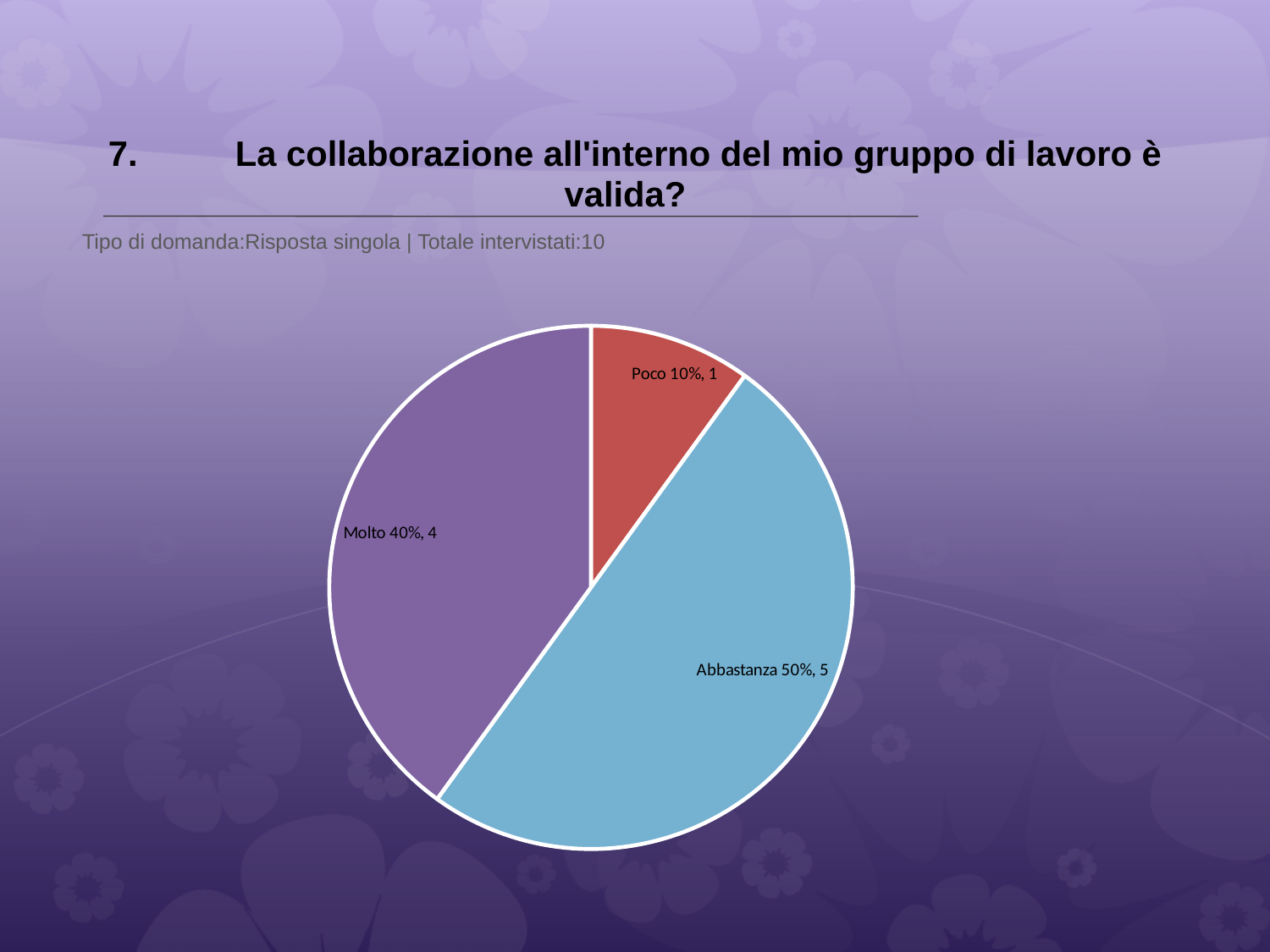
How many respondents answered 'Molto'? 4 Which response category has the largest slice? Abbastanza Which response category has the smallest slice? Poco How many slices does the pie chart have? 3 What kind of chart is shown on the slide? pie chart What percentage share does the 'Abbastanza' slice have? 50% How many respondents answered 'Abbastanza'? 5 What percentage share does the 'Molto' slice have? 40% What is the difference in number of respondents between 'Abbastanza' and 'Poco'? 4 How many respondents answered 'Poco'? 1 Which slice is larger, 'Molto' or 'Poco'? Molto What percentage share does the 'Poco' slice have? 10%